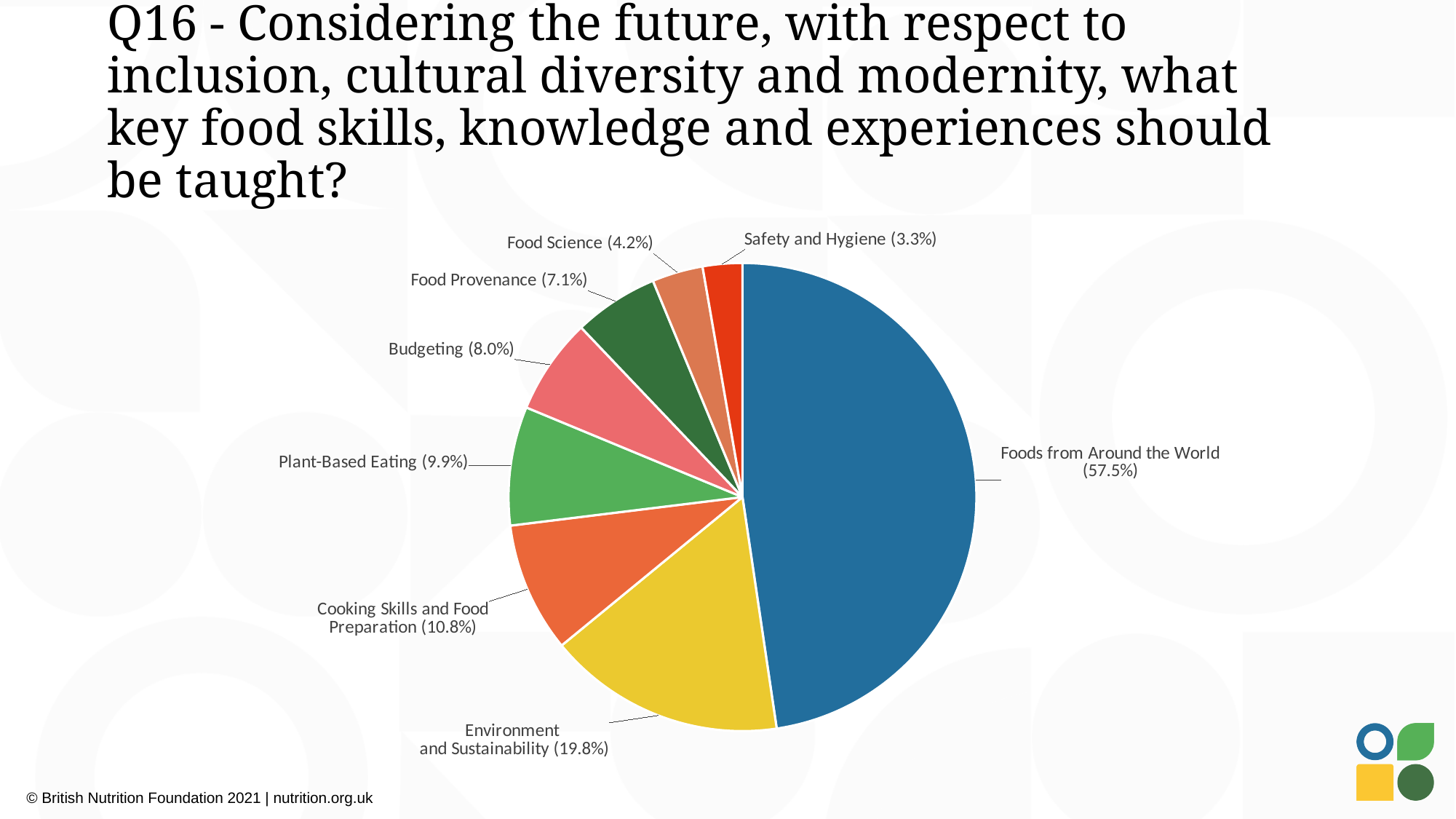
What is the value for Food Provenance? 7.1% What is the value for Plant-Based Eating? 9.9% What colour is the Foods from Around the World slice? blue How many categories are shown in the pie chart? 8 Which is larger, Budgeting or Food Science? Budgeting What is the difference between the values for Environment and Sustainability and Cooking Skills and Food Preparation? 9.0% What is the value for Environment and Sustainability? 19.8% Which category has the largest slice of the pie? Foods from Around the World What kind of chart is shown on the slide? pie chart What is the value for Cooking Skills and Food Preparation? 10.8% Which category has the smallest slice of the pie? Safety and Hygiene What share of the pie does Foods from Around the World have? 57.5%